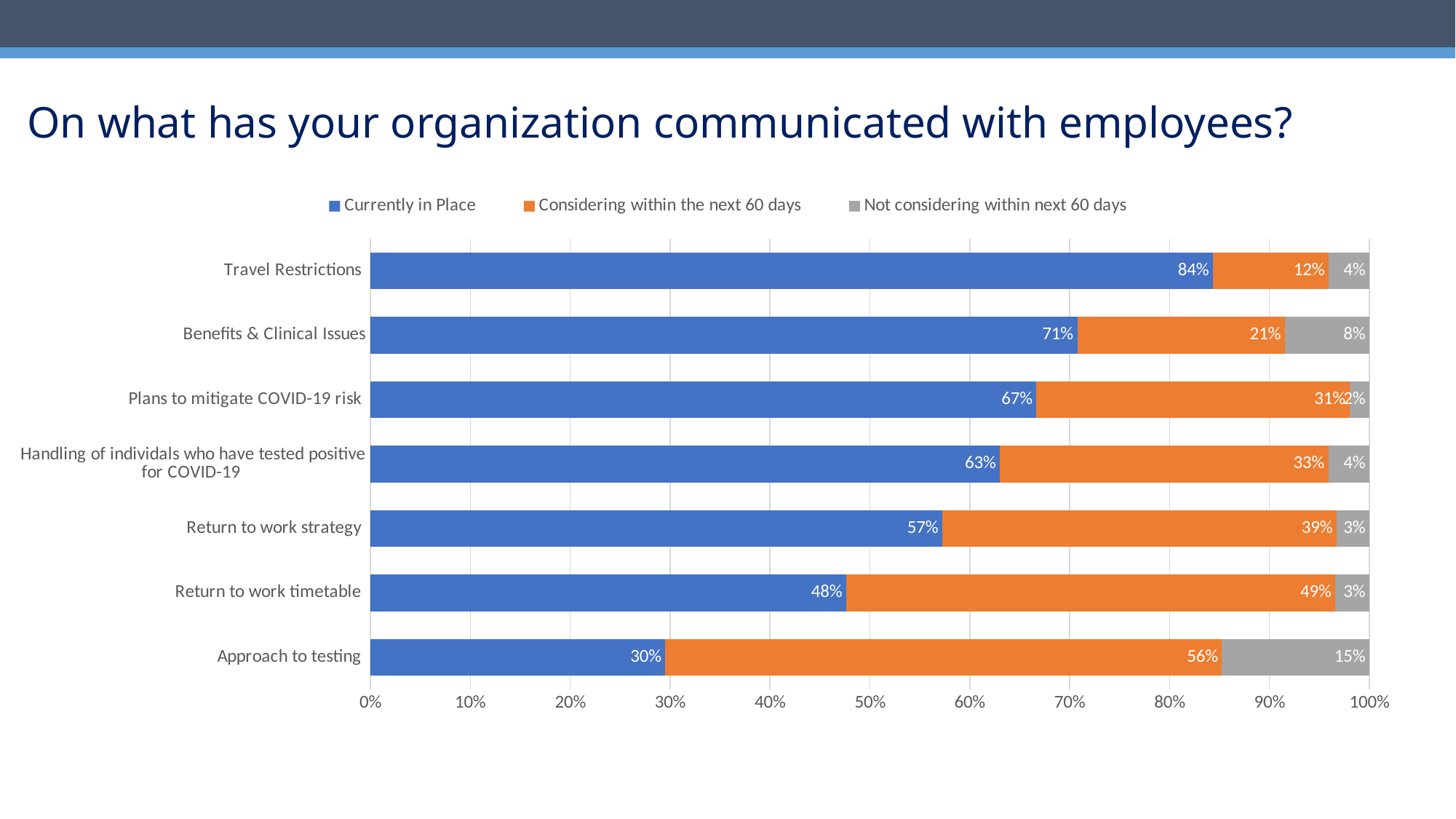
Which category has the highest 'Not considering within next 60 days' value? Approach to testing Which category has the lowest 'Currently in Place' value? Approach to testing Which category has the highest 'Currently in Place' value? Travel Restrictions How many series does the legend list? 3 How many categories are shown on the chart? 7 What kind of chart is shown on the slide? Stacked bar chart What is the 'Considering within the next 60 days' value for Approach to testing? 56% What percentage of organizations have Travel Restrictions currently in place? 84% What is the 'Not considering within next 60 days' value for Benefits & Clinical Issues? 8% Which is larger for Return to work strategy: 'Currently in Place' or 'Considering within the next 60 days'? Currently in Place What is the difference between the 'Currently in Place' values for Travel Restrictions and Return to work timetable? 36%